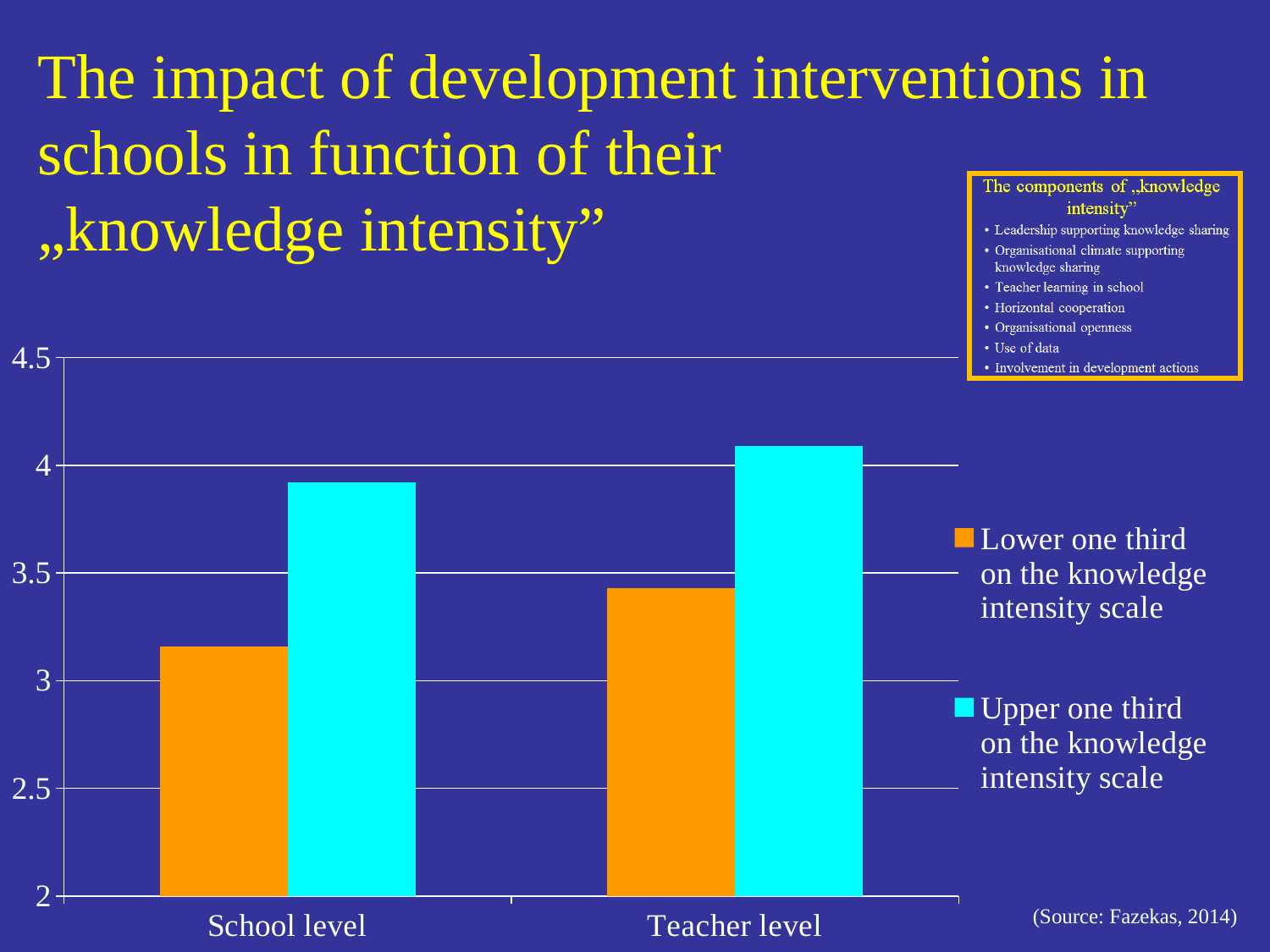
Is the value for the Lower one third at School level greater or less than 3? greater At School level, which is larger: the Lower one third or the Upper one third on the knowledge intensity scale? Upper one third on the knowledge intensity scale Do the values for the Upper one third series rise or fall from School level to Teacher level? rise What kind of chart is shown on the slide? bar chart For the Lower one third series, which category has the larger value: School level or Teacher level? Teacher level Which bar is the lowest in the chart? Lower one third on the knowledge intensity scale, School level How many categories are shown on the x axis of the chart? 2 Is the value for the Upper one third at School level greater or less than 4? less How many series does the chart's legend list? 2 What colour are the bars for the Lower one third on the knowledge intensity scale? orange Which bar is the highest in the chart? Upper one third on the knowledge intensity scale, Teacher level Is the value for the Upper one third at Teacher level greater or less than 4? greater